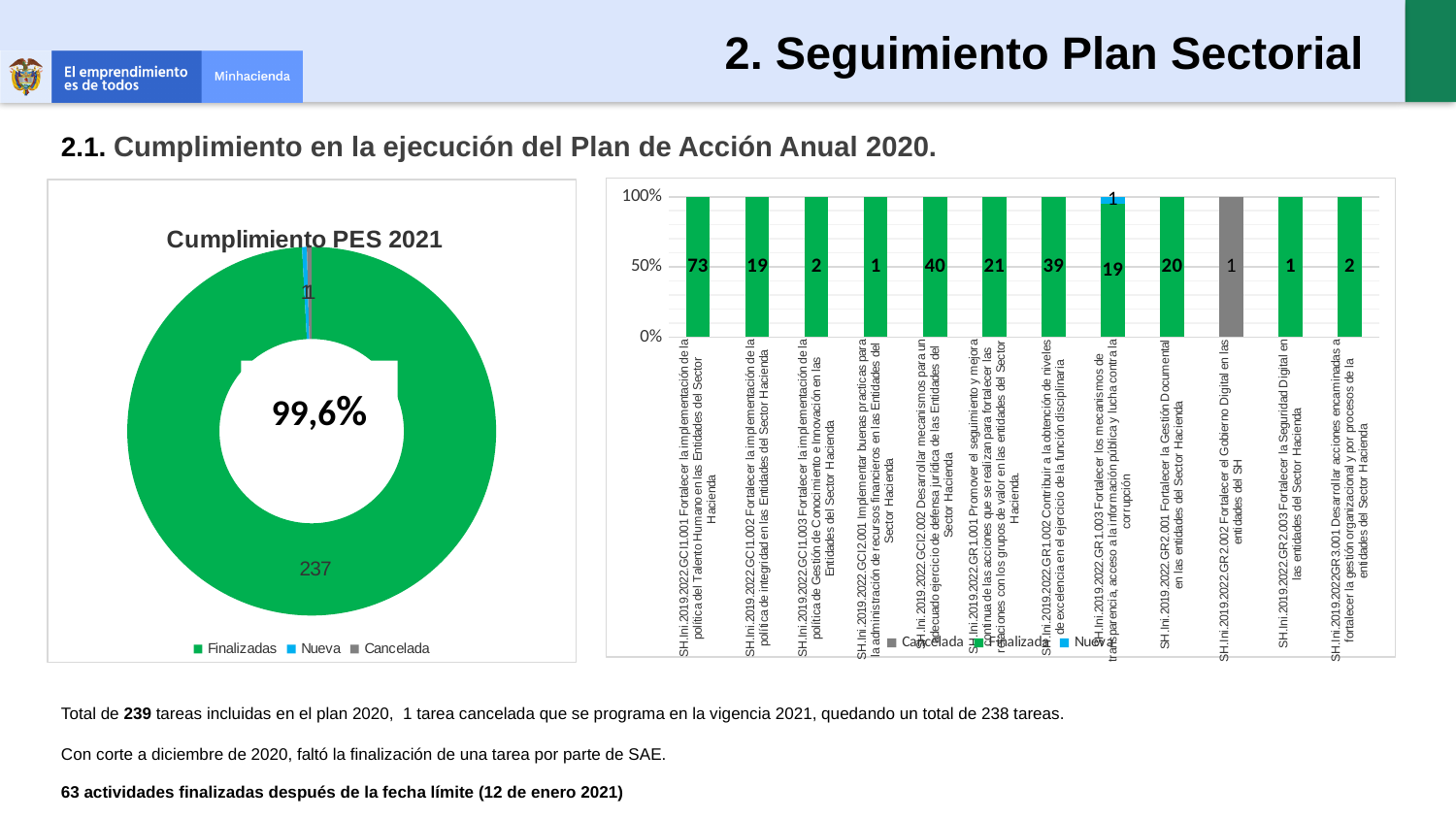
In the chart on the right, what is the difference between the labels for SH.Ini.2019.2022.GCI1.001 (73) and SH.Ini.2019.2022.GCI1.002 (19)? 54 In the chart on the right, what is the data label on the bar for SH.Ini.2019.2022.GCI1.001 (Fortalecer la implementación de la política del Talento Humano)? 73 How many entries does the legend of the 'Cumplimiento PES 2021' chart list? 3 In the chart on the right, which bar is shown in grey (Cancelada)? SH.Ini.2019.2022.GR2.002 Fortalecer el Gobierno Digital en las entidades del SH In the 'Cumplimiento PES 2021' chart, what is the value for Finalizadas? 237 How many categories (bars) does the chart on the right show? 12 In the chart on the right, what is the data label on the bar for SH.Ini.2019.2022.GR2.001 (Fortalecer la Gestión Documental)? 20 What kind of chart is the 'Cumplimiento PES 2021' chart on the left? Doughnut chart In the 'Cumplimiento PES 2021' chart, what percentage is shown in the centre of the doughnut? 99,6% In the 'Cumplimiento PES 2021' chart, which category has the largest slice? Finalizadas What kind of chart is the chart on the right of the slide? Stacked bar chart How many series does the legend of the chart on the right list? 3